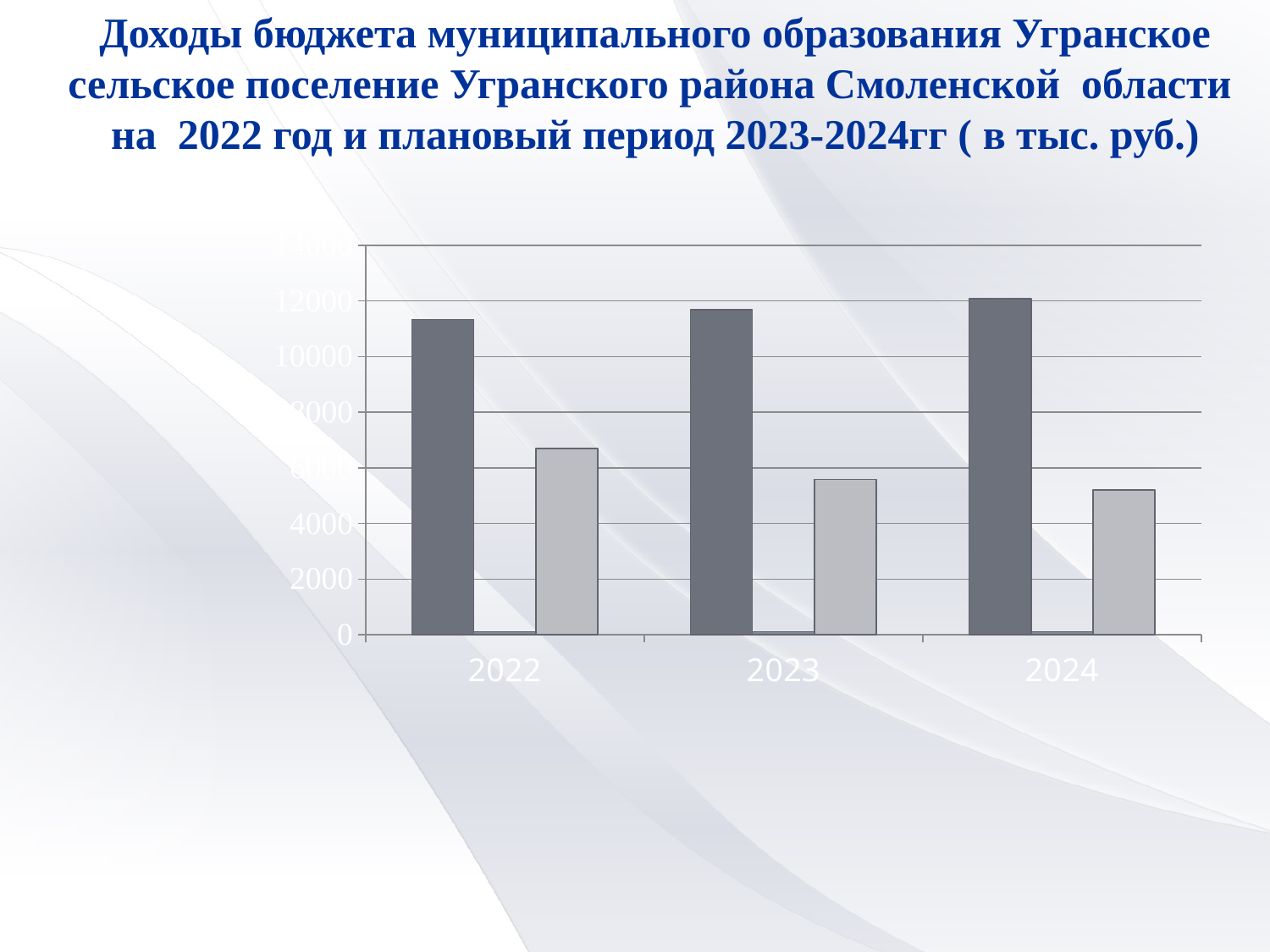
Do the dark grey bars rise or fall from 2022 to 2024? rise What kind of chart is shown on the slide? bar chart Is the value of the dark grey bar for 2022 greater or less than 12000? less Is the value of the light grey bar for 2024 greater or less than 6000? less How many years are shown on the x axis of the chart? 3 In which year is the dark grey bar the highest? 2024 Do the light grey bars rise or fall from 2022 to 2024? fall Is the value of the dark grey bar for 2023 greater or less than 10000? greater In which year is the light grey bar the highest? 2022 Which years are shown on the x axis of the chart? 2022, 2023, 2024